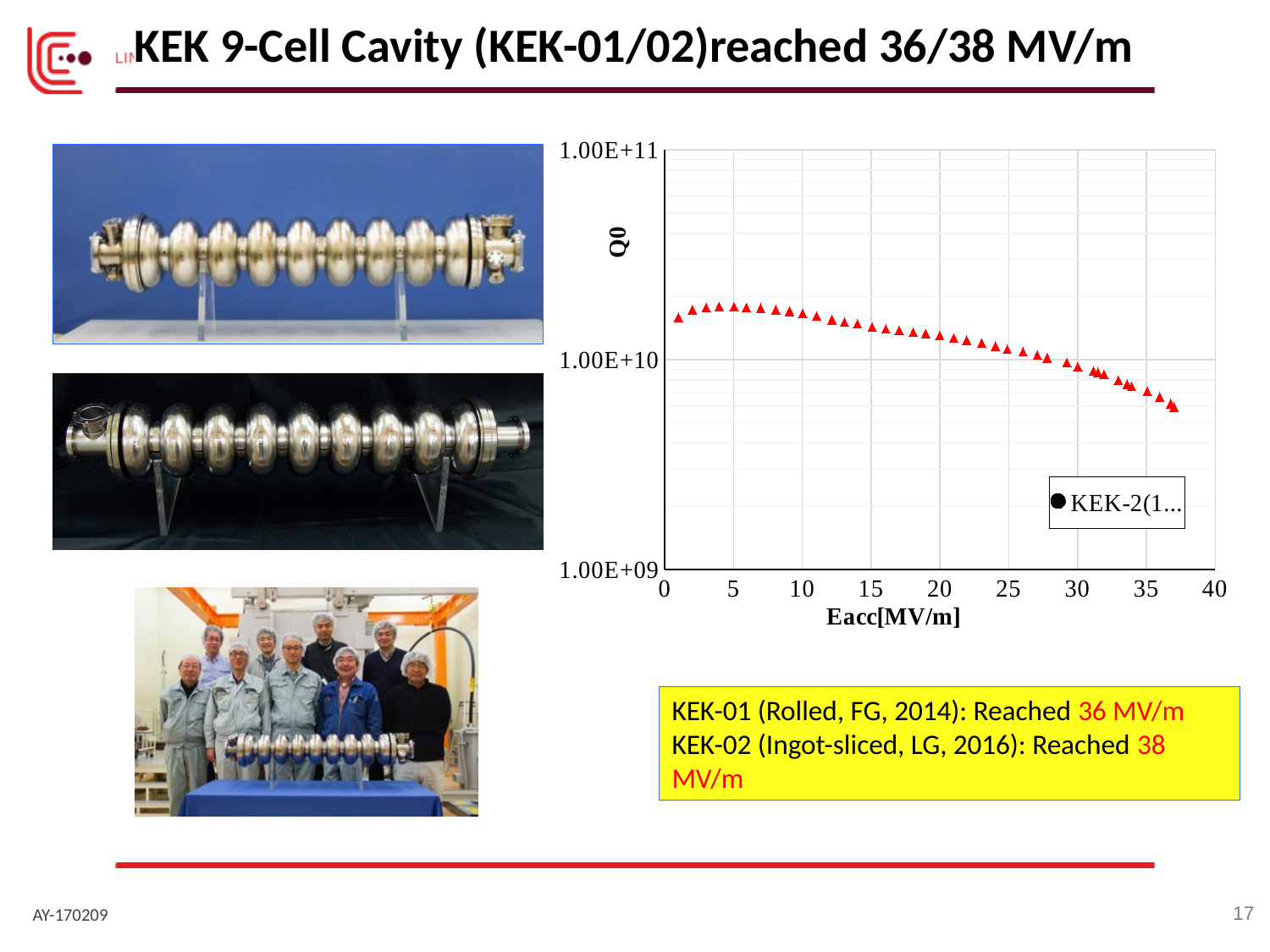
What is the lowest tick value shown on the y axis of the chart? 1.00E+09 What kind of chart is shown on the slide? Scatter chart Is the Q0 value at Eacc = 5 MV/m greater or less than 1.00E+11? less What is the highest tick value shown on the x axis of the chart? 40 What is the label of the y axis of the chart? Q0 Is the Q0 value at Eacc = 35 MV/m greater or less than 1.00E+10? less Is Q0 higher at Eacc = 5 MV/m or at Eacc = 35 MV/m? Eacc = 5 MV/m Is the Q0 value at Eacc = 5 MV/m greater or less than 1.00E+10? greater How many series does the chart's legend list? 1 As Eacc increases along the x axis, does Q0 rise or fall? Fall What is the label of the x axis of the chart? Eacc[MV/m]